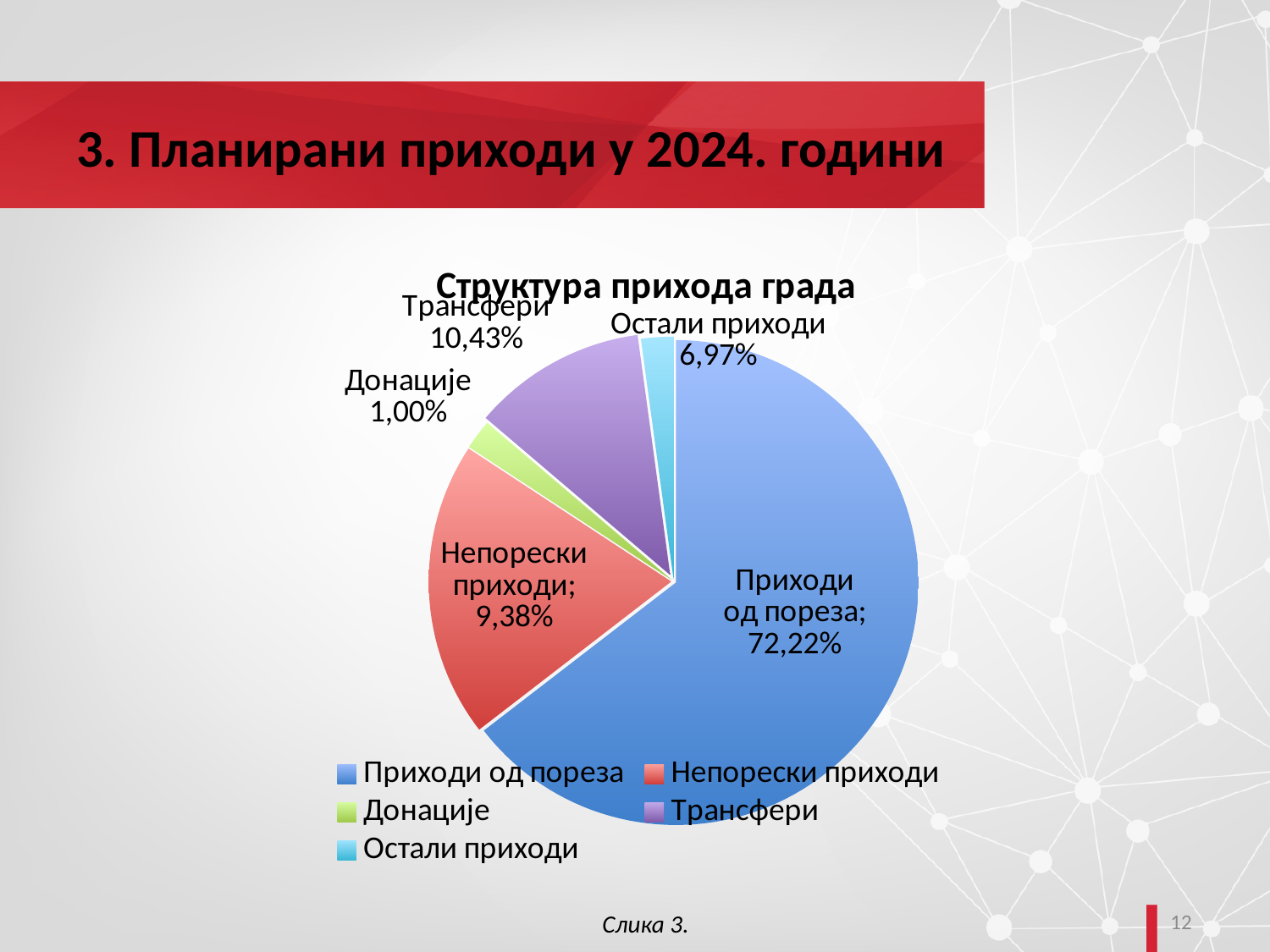
What is the value for Непорески приходи? 9,38% What is the value for Трансфери? 10,43% Which category has the smallest share of the pie? Донације What is the title of the chart? Структура прихода града What is the value for Донације? 1,00% What is the value for Остали приходи? 6,97% Which category has the largest share of the pie? Приходи од пореза What share of the pie does Приходи од пореза have? 72,22% What type of chart is shown on the slide? pie chart What is the difference between the shares of Трансфери and Остали приходи? 3,46% How many categories does the legend list? 5